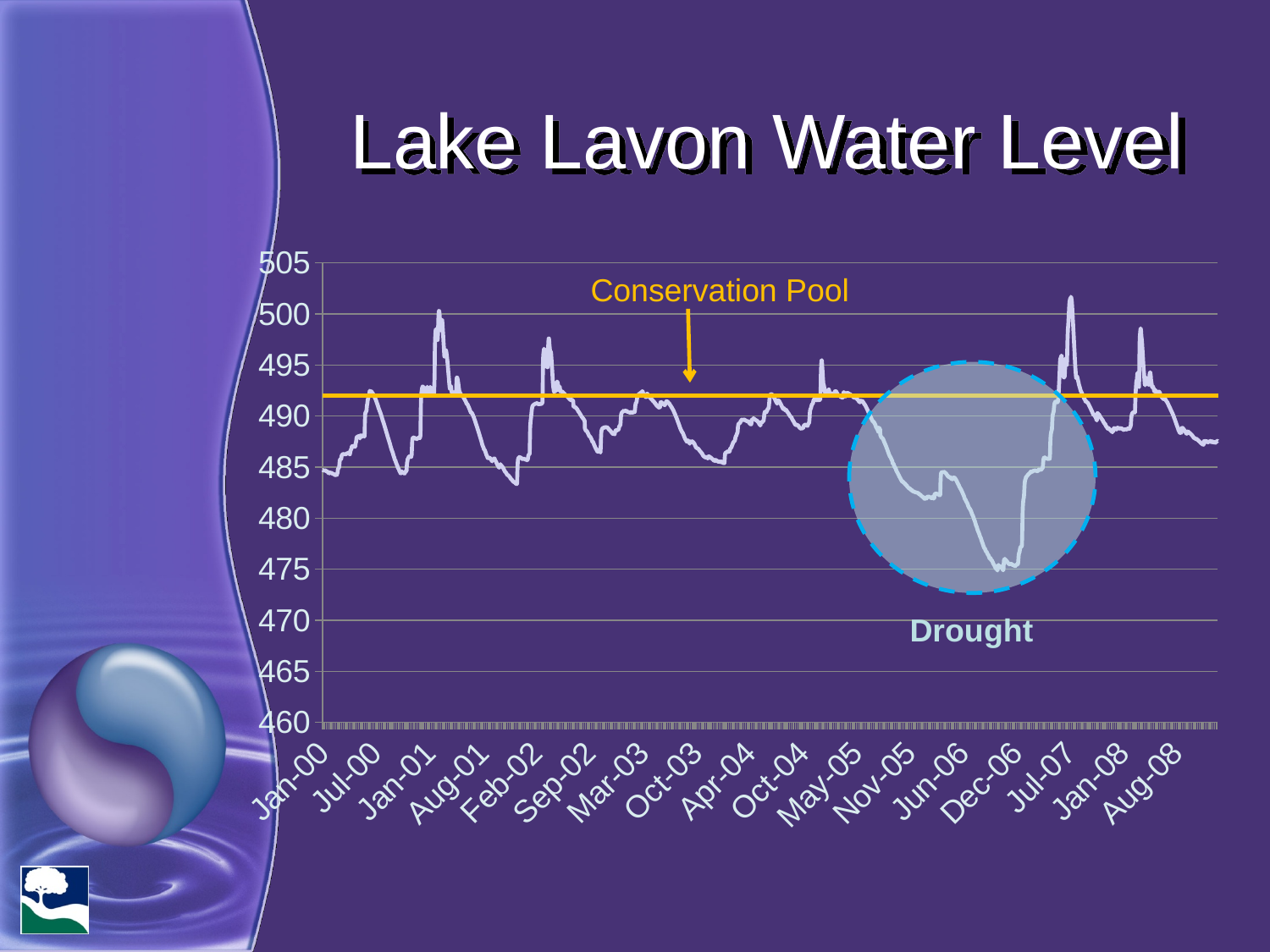
How many date labels are shown along the x axis? 17 Is the Conservation Pool line greater or less than 490? greater Is the water level higher at the Jul-07 peak or at the Dec-06 low? Jul-07 Is the water level at Aug-08 greater or less than 490? less Is the water level at Jan-00 greater or less than 490? less Around which x-axis label does the water level reach its lowest point? Dec-06 What is the title of the chart? Lake Lavon Water Level What does the horizontal orange line on the chart represent? Conservation Pool Around which x-axis label does the water level reach its highest peak? Jul-07 What kind of chart is shown on the slide? line chart